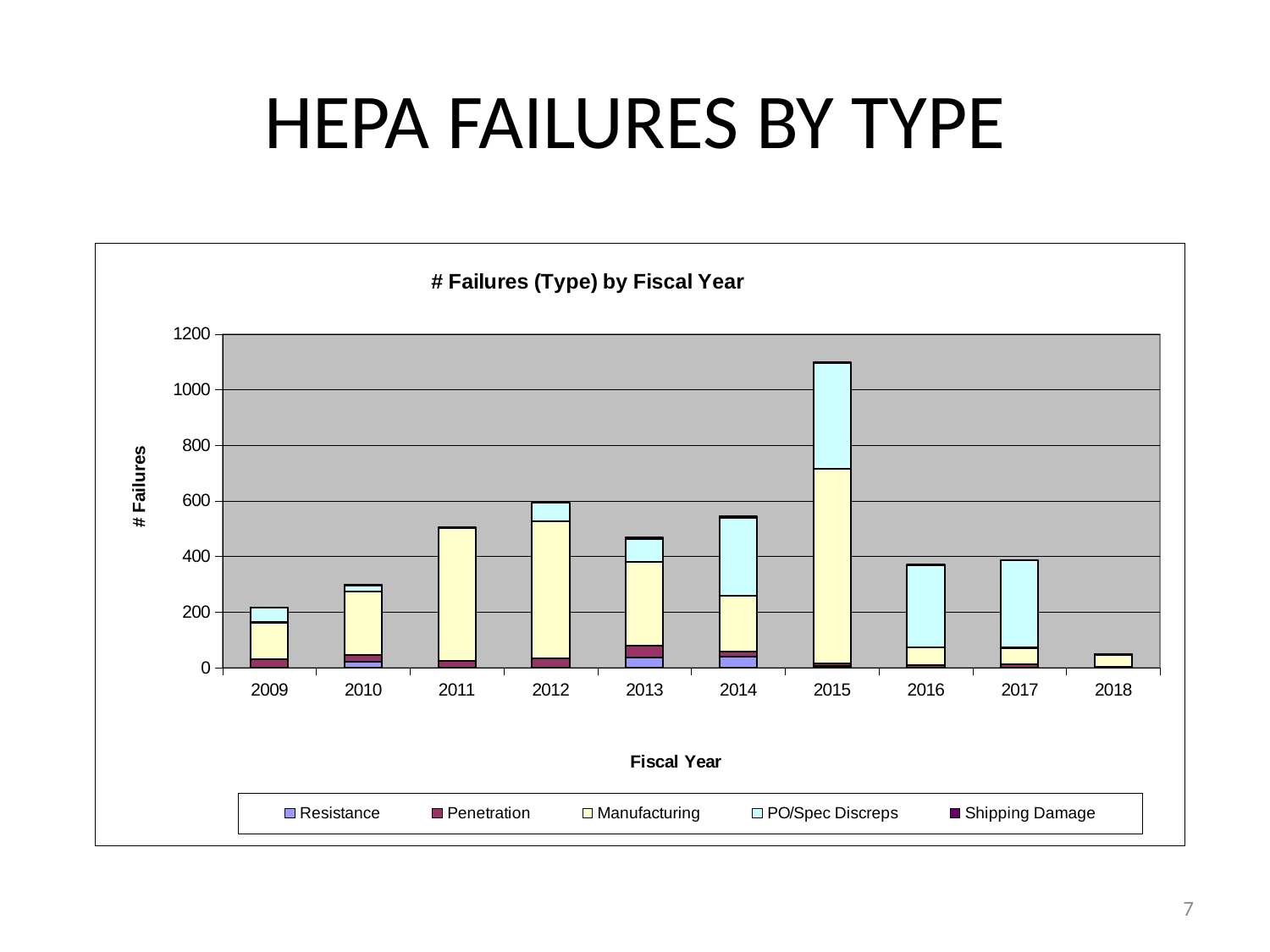
Is the total value for 2011 greater or less than 400? greater Is the total value for 2018 greater or less than 200? less Is the total value for 2015 greater or less than 1000? greater Which fiscal year has a larger total number of failures, 2010 or 2011? 2011 What kind of chart is shown on the slide? stacked bar chart Which fiscal year has the lowest total number of failures? 2018 How many series does the legend list? 5 What is the title of the chart? # Failures (Type) by Fiscal Year How many fiscal years are shown on the x axis? 10 Which fiscal year has the highest total number of failures? 2015 Do the total failures rise or fall from 2015 to 2018? fall